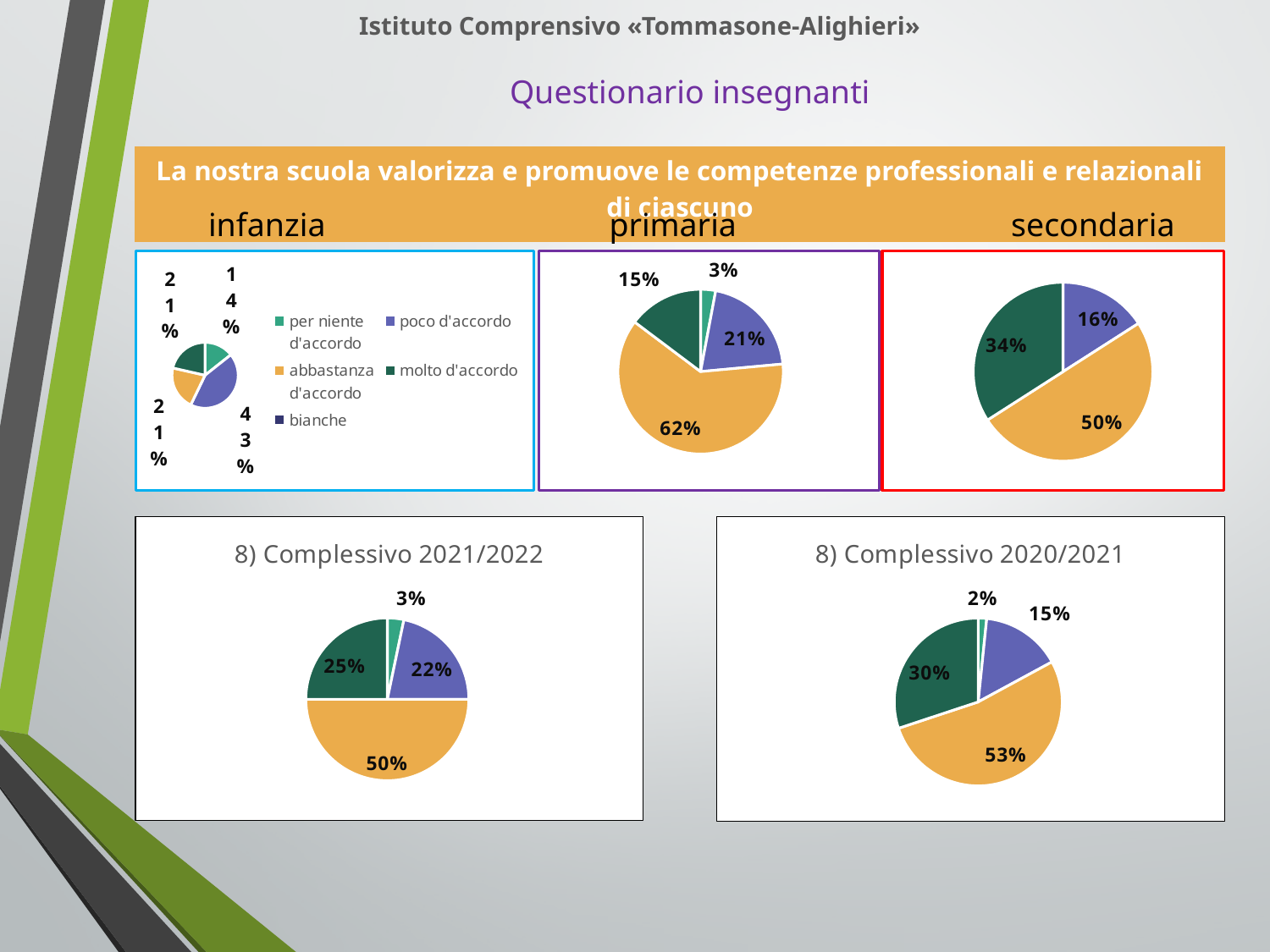
In the primaria pie chart, what percentage is shown for the abbastanza d'accordo (orange) slice? 62% In the chart titled '8) Complessivo 2020/2021', what percentage is shown for the abbastanza d'accordo (orange) slice? 53% How many labelled slices does the secondaria pie chart have? 3 Comparing the two Complessivo charts, is the molto d'accordo share larger in 2021/2022 or in 2020/2021? 2020/2021 In the primaria pie chart, which slice has the smallest share? per niente d'accordo In the primaria pie chart, which slice has the largest share? abbastanza d'accordo In the chart titled '8) Complessivo 2020/2021', what is the difference between the abbastanza d'accordo slice and the molto d'accordo slice? 23% In the chart titled '8) Complessivo 2021/2022', what percentage is shown for the poco d'accordo (purple) slice? 22% In the secondaria pie chart, what percentage is shown for the molto d'accordo (dark green) slice? 34% In the secondaria pie chart, what is the difference between the abbastanza d'accordo slice and the poco d'accordo slice? 34% What kind of chart is used for the secondaria data? pie chart How many entries does the legend in the infanzia chart list? 5